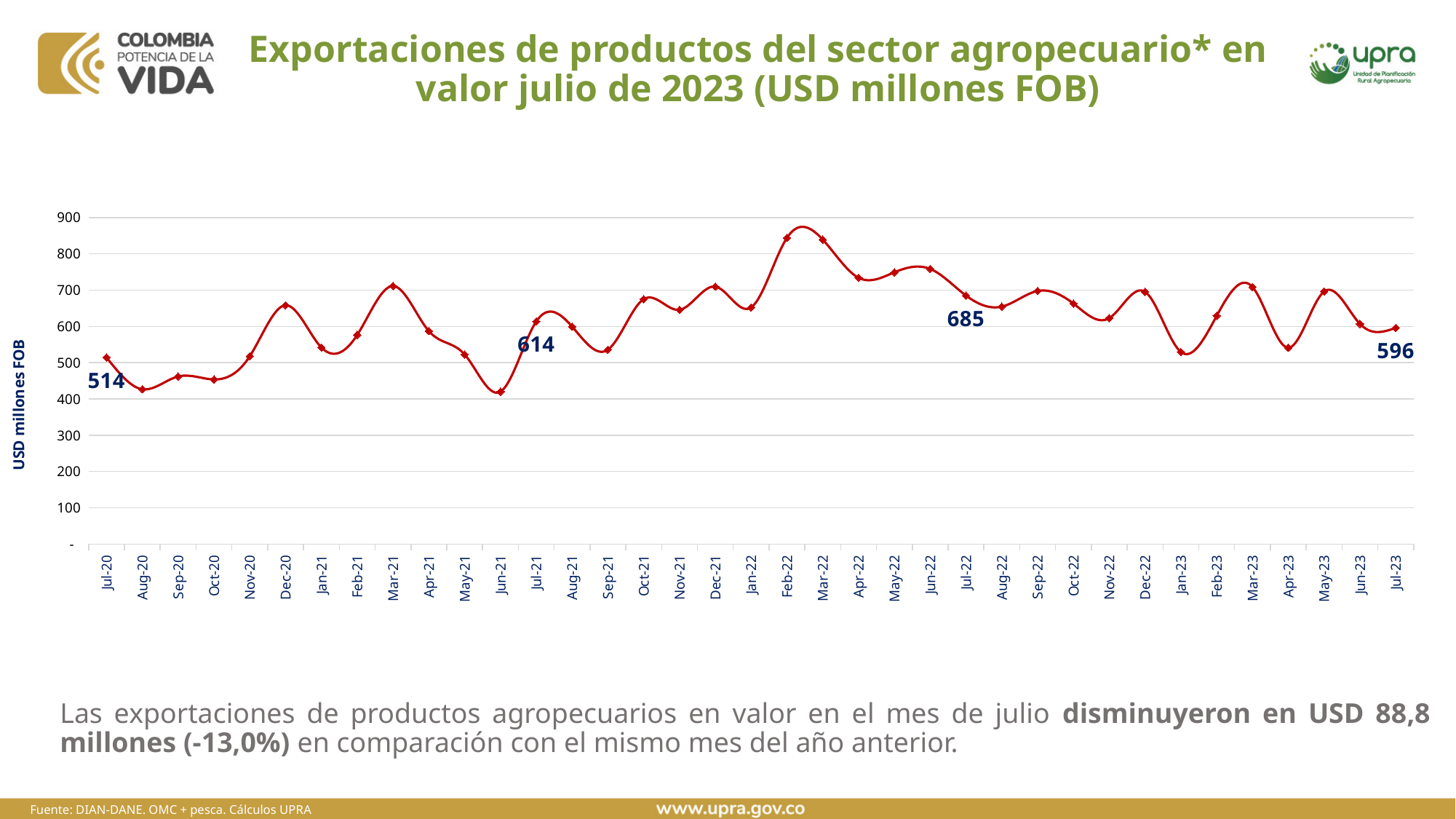
What is the label on the vertical axis of the chart? USD millones FOB What is the difference between the values for Jul-21 and Jul-20? 100 How many monthly data points are plotted on the chart? 37 What is the value for Jul-21? 614 What is the difference between the values for Jul-22 and Jul-23? 89 What is the value for Jul-20? 514 What is the value for Jul-22? 685 Is the value for Feb-22 greater or less than 800? greater What is the value for Jul-23? 596 Which is larger, the value for Jul-22 or the value for Jul-21? Jul-22 Is the value for Jun-21 greater or less than 500? less What kind of chart is shown on the slide? line chart